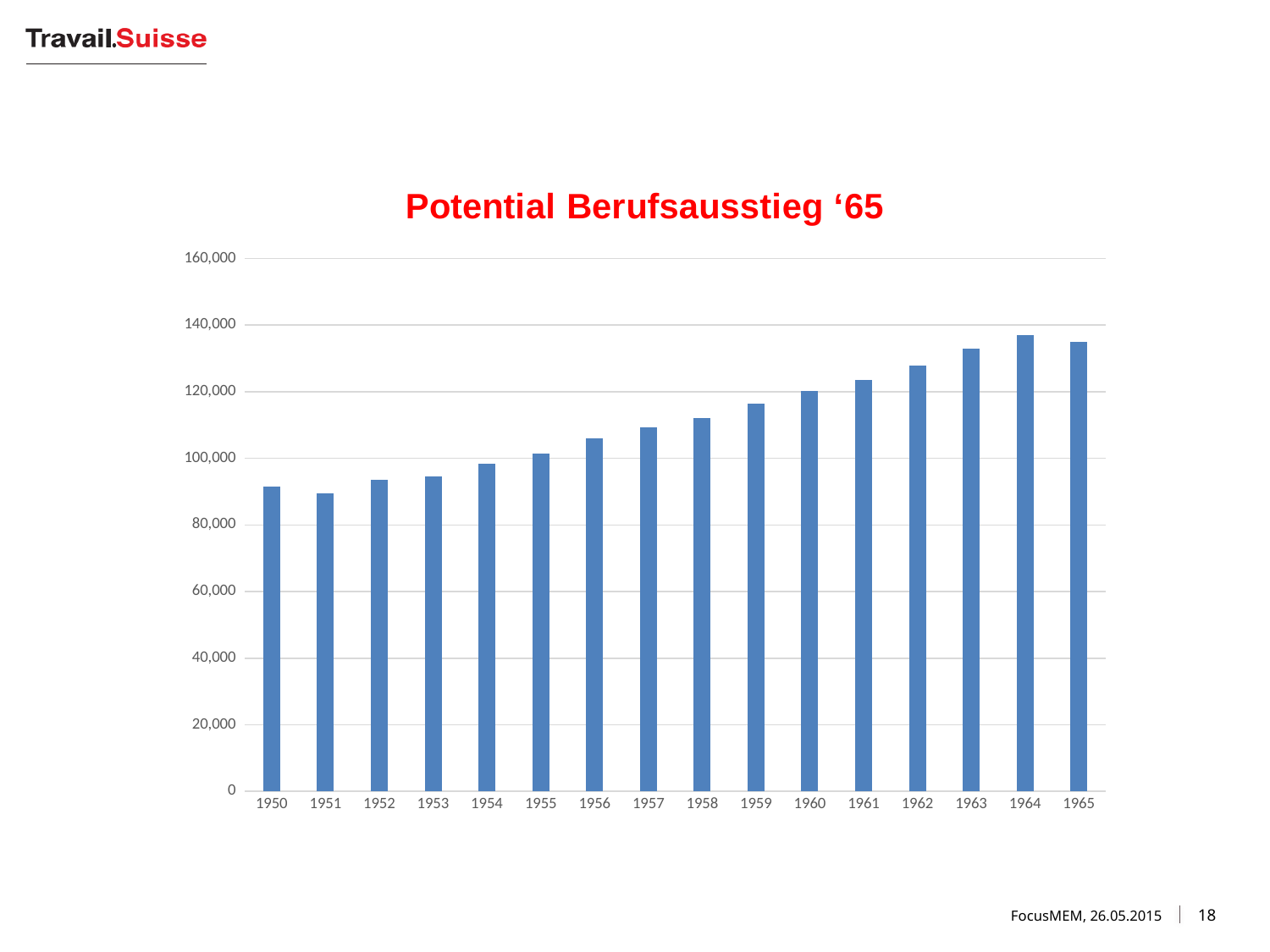
Which is larger, the value for 1965 or the value for 1950? 1965 Is the value for 1950 greater or less than 100,000? less How many years are shown on the x axis of the chart? 16 Is the value for 1958 greater or less than 100,000? greater What kind of chart is shown on the slide? bar chart Which is larger, the value for 1954 or the value for 1959? 1959 Which year has the lowest bar in the chart? 1951 Which year has the highest bar in the chart? 1964 Is the value for 1964 greater or less than 140,000? less What is the title of the chart? Potential Berufsausstieg '65 Do the values generally rise or fall from 1950 to 1964? rise